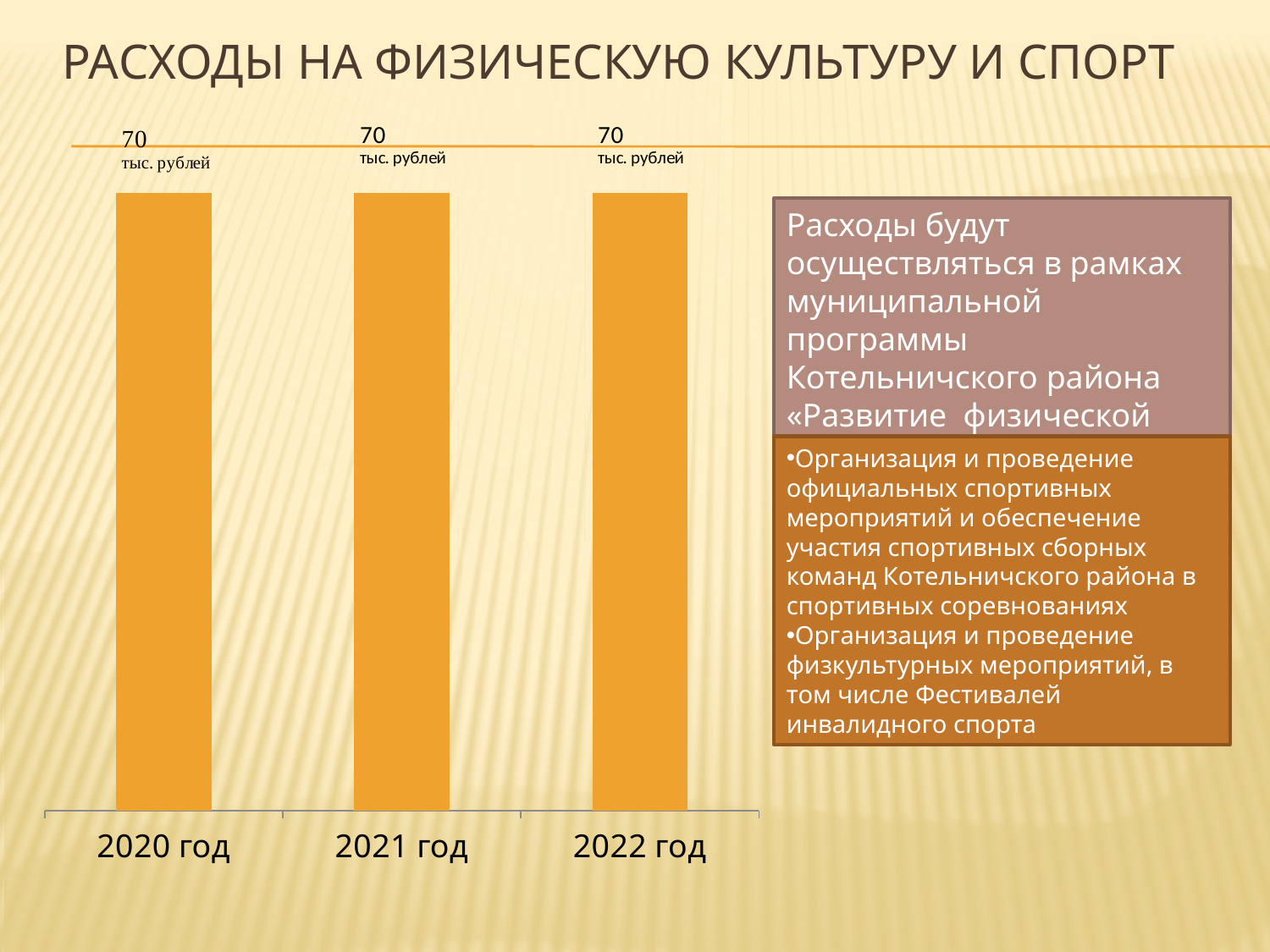
What is the title of the slide containing the chart? РАСХОДЫ НА ФИЗИЧЕСКУЮ КУЛЬТУРУ И СПОРТ What is the difference between the values for 2020 год and 2022 год? 0 What is the value for 2022 год? 70 тыс. рублей Do the values rise, fall, or stay the same from 2020 год to 2022 год? Stay the same What is the value for 2020 год? 70 тыс. рублей What is the value for 2021 год? 70 тыс. рублей What colour are the bars in the chart? Orange What kind of chart is shown on the slide? Bar chart What is the difference between the values for 2021 год and 2020 год? 0 How many categories (years) are shown in the chart? 3